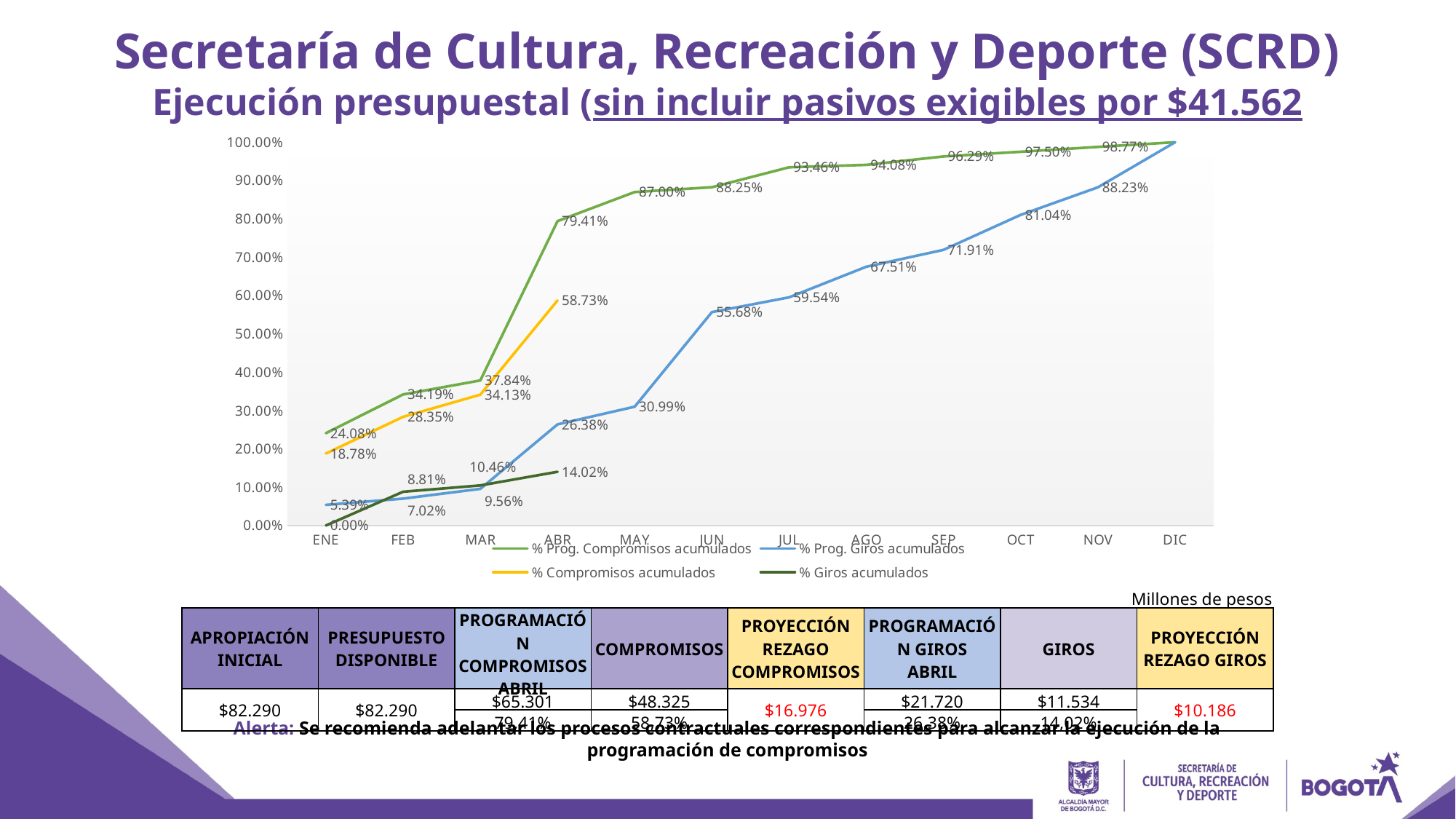
In MAR, which is larger: % Prog. Compromisos acumulados or % Compromisos acumulados? % Prog. Compromisos acumulados In ABR, what is the difference between % Prog. Compromisos acumulados and % Compromisos acumulados? 20.68% Does % Prog. Giros acumulados rise or fall from ENE to DIC? Rise What is the value of % Compromisos acumulados in ABR? 58.73% How many series does the chart legend list? 4 What is the value of % Giros acumulados in ENE? 0.00% How many months are shown along the x axis of the chart? 12 What is the value of % Giros acumulados in ABR? 14.02% What is the value of % Prog. Giros acumulados in NOV? 88.23% What is the value of % Prog. Compromisos acumulados in ABR? 79.41% What kind of chart is shown on the slide? Line chart In ABR, what is the difference between % Prog. Giros acumulados and % Giros acumulados? 12.36%